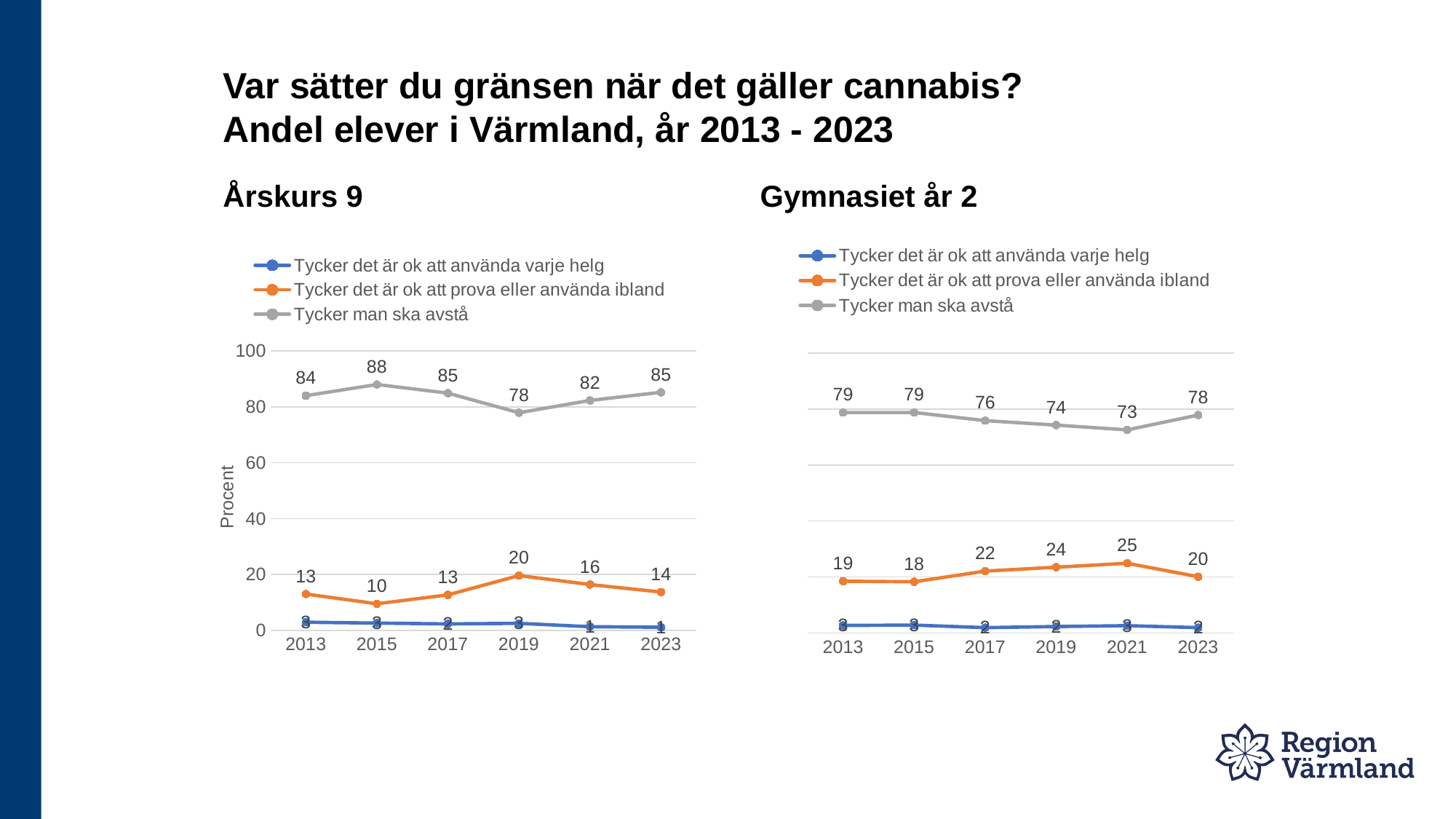
In the Gymnasiet år 2 chart, in which year is "Tycker det är ok att prova eller använda ibland" highest? 2021 What kind of chart is the Årskurs 9 chart? Line chart How many years are plotted on the x axis of the Årskurs 9 chart? 6 In the Årskurs 9 chart, what is the value for "Tycker det är ok att prova eller använda ibland" in 2019? 20 In the Gymnasiet år 2 chart, what is the value for "Tycker det är ok att prova eller använda ibland" in 2023? 20 In the Gymnasiet år 2 chart, what is the value for "Tycker man ska avstå" in 2021? 73 In the Årskurs 9 chart, what is the value for "Tycker man ska avstå" in 2015? 88 In the Årskurs 9 chart, in which year is "Tycker man ska avstå" lowest? 2019 How many series does the legend of the Gymnasiet år 2 chart list? 3 In the Årskurs 9 chart, what is the difference between the 2015 and 2019 values for "Tycker man ska avstå"? 10 Which is larger: the 2023 value for "Tycker man ska avstå" in the Årskurs 9 chart or in the Gymnasiet år 2 chart? Årskurs 9 In the Gymnasiet år 2 chart, what is the difference between the 2021 and 2013 values for "Tycker det är ok att prova eller använda ibland"? 6